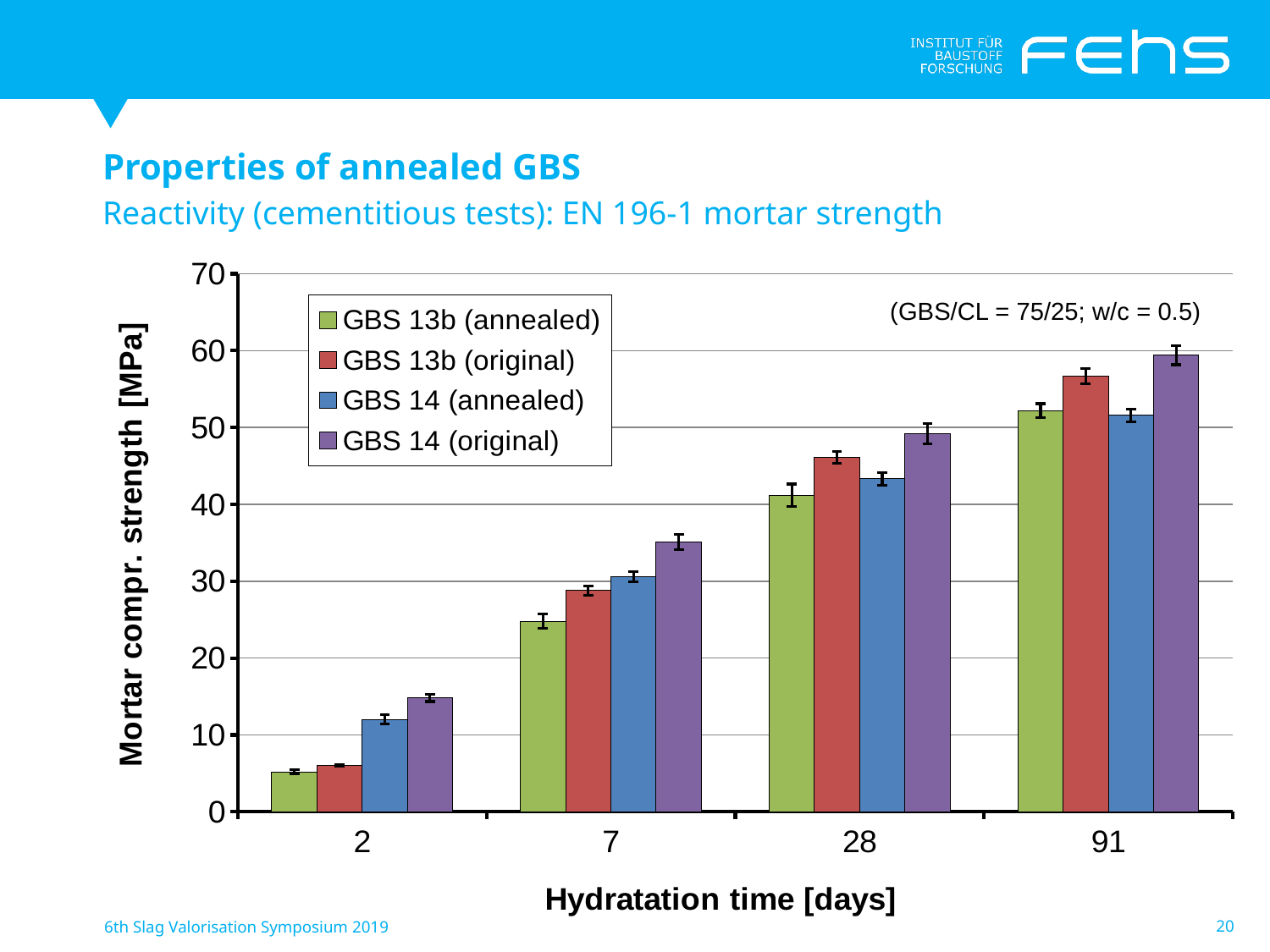
Which series has the highest bar at 91 days? GBS 14 (original) Is the value for GBS 13b (annealed) at 2 days greater or less than 10? less How many hydration time categories are shown on the x axis? 4 How many series does the legend list? 4 Do the values for GBS 14 (original) rise or fall as hydration time increases? rise What is the label of the y axis? Mortar compr. strength [MPa] At 28 days, which is larger: GBS 13b (original) or GBS 14 (annealed)? GBS 13b (original) What kind of chart is shown on the slide? bar chart Which series has the lowest bar at 2 days? GBS 13b (annealed) Is the value for GBS 14 (original) at 7 days greater or less than 30? greater At 7 days, which is larger: GBS 13b (annealed) or GBS 14 (original)? GBS 14 (original) Is the value for GBS 13b (annealed) at 28 days greater or less than 50? less